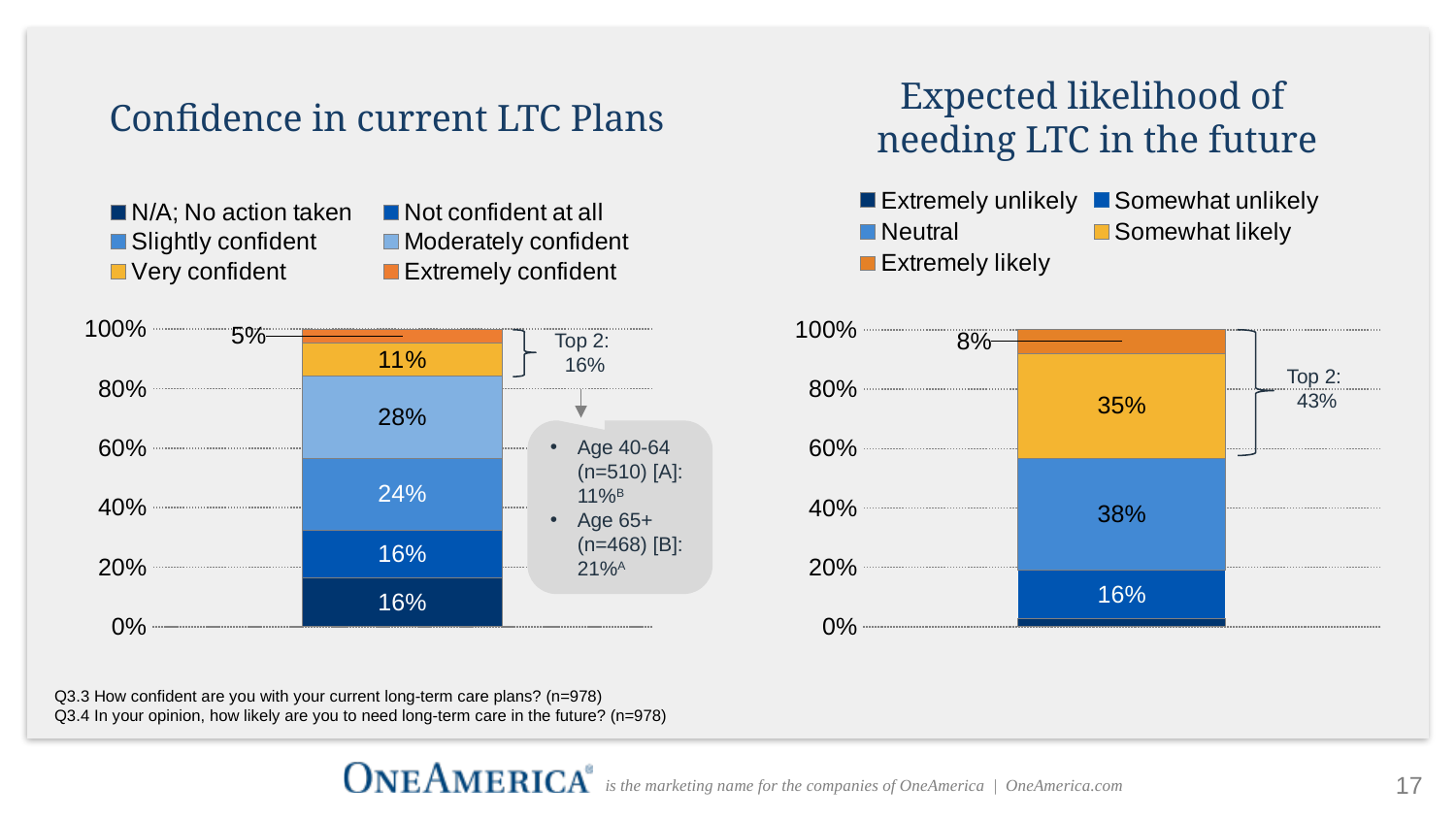
What kind of chart is used for 'Expected likelihood of needing LTC in the future'? Stacked bar chart In the 'Confidence in current LTC Plans' chart, which segment has the largest value? Moderately confident In the 'Expected likelihood of needing LTC in the future' chart, what is the difference between Neutral and Somewhat likely? 3% In the 'Expected likelihood of needing LTC in the future' chart, how many series does the legend list? 5 In the 'Expected likelihood of needing LTC in the future' chart, what percentage is shown for Extremely likely? 8% In the 'Expected likelihood of needing LTC in the future' chart, what Top 2 value is annotated? 43% In the 'Expected likelihood of needing LTC in the future' chart, which is larger, Somewhat unlikely or Somewhat likely? Somewhat likely In the 'Confidence in current LTC Plans' chart, what percentage is shown for Moderately confident? 28% In the 'Confidence in current LTC Plans' chart, how many series does the legend list? 6 In the 'Confidence in current LTC Plans' chart, what percentage is shown for Extremely confident? 5% In the 'Confidence in current LTC Plans' chart, what is the difference between Slightly confident and Very confident? 13% In the 'Expected likelihood of needing LTC in the future' chart, what percentage is shown for Neutral? 38%